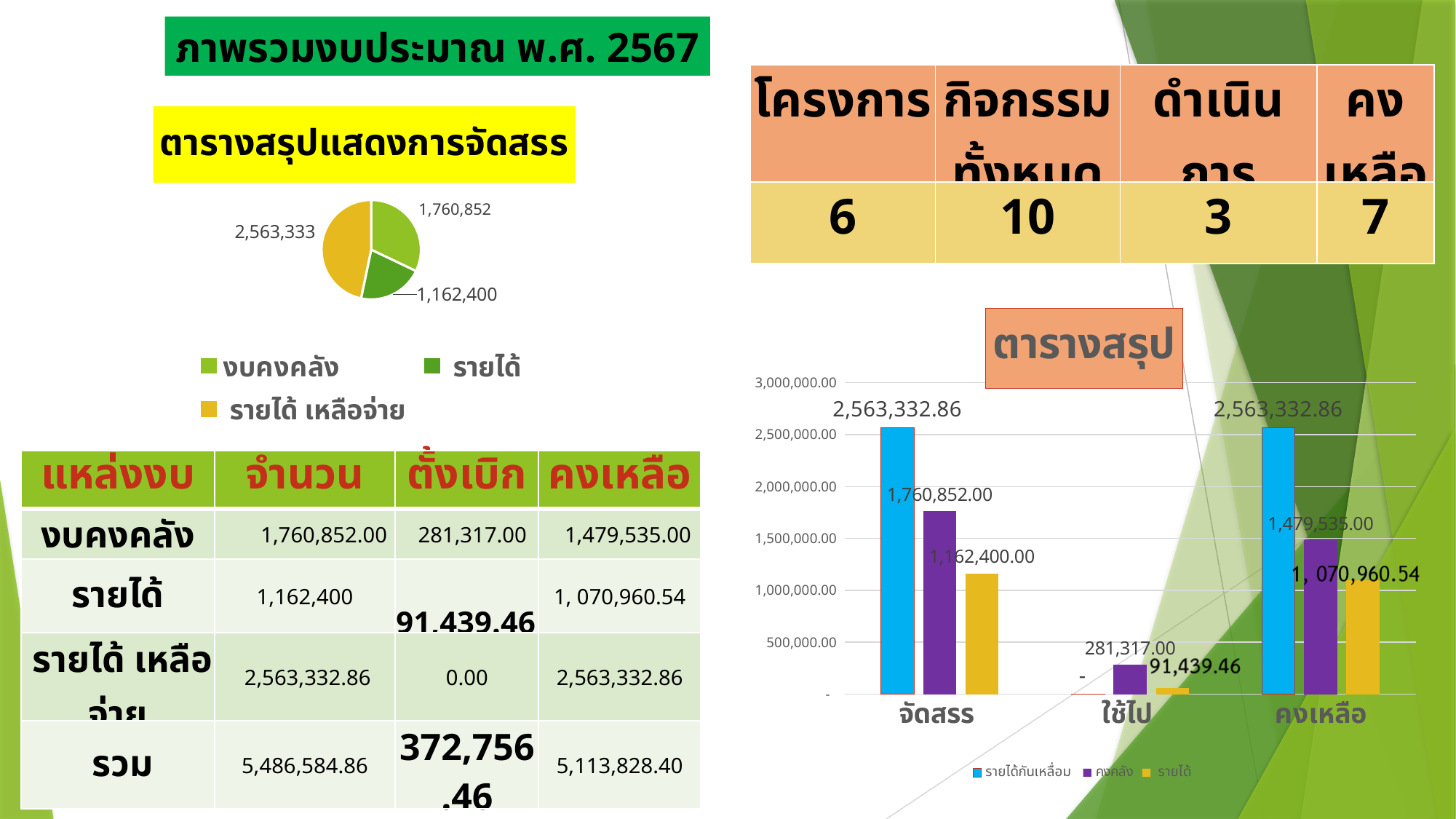
In the pie chart on the left, what value is shown for the งบคงคลัง slice? 1,760,852 In the ตารางสรุป bar chart, how many categories are shown on the x axis? 3 In the ตารางสรุป bar chart, what is the value of รายได้ for the category คงเหลือ? 1, 070,960.54 What kind of chart is the ตารางสรุป chart on the right? bar chart In the pie chart on the left, what is the difference between the รายได้ เหลือจ่าย slice and the งบคงคลัง slice? 802,481 In the pie chart on the left, which category has the smallest slice? รายได้ In the ตารางสรุป bar chart, which is larger for the category จัดสรร: รายได้กันเหลื่อม or คงคลัง? รายได้กันเหลื่อม What kind of chart is the chart on the left under the heading ตารางสรุปแสดงการจัดสรร? pie chart In the ตารางสรุป bar chart, what is the value of คงคลัง for the category ใช้ไป? 281,317.00 How many entries does the legend of the pie chart on the left list? 3 In the ตารางสรุป bar chart, what is the difference between คงคลัง and รายได้ for the category ใช้ไป? 189,877.54 In the pie chart on the left, which category has the largest slice? รายได้ เหลือจ่าย